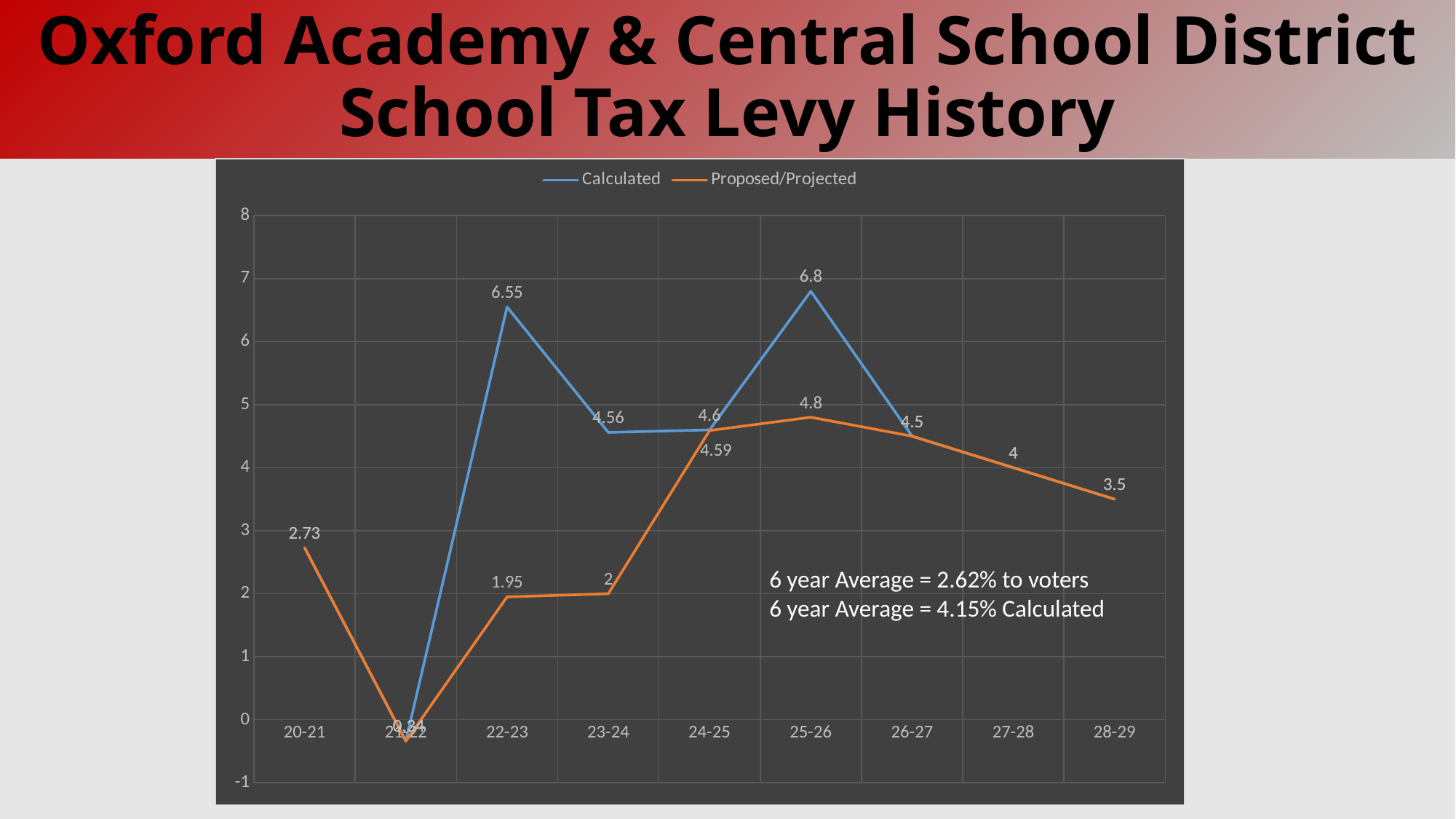
What is the difference between the Calculated values for 25-26 and 22-23? 0.25 For 23-24, which is larger: the Calculated value or the Proposed/Projected value? Calculated What is the Proposed/Projected value for 22-23? 1.95 What is the Proposed/Projected value for 28-29? 3.5 What kind of chart is shown on the slide? Line chart In which year is the Proposed/Projected series highest? 25-26 Does the Proposed/Projected series rise or fall from 25-26 to 28-29? Fall In which year is the Calculated series highest? 25-26 What is the Proposed/Projected value for 20-21? 2.73 What is the Calculated value for 22-23? 6.55 How many school years are shown on the x axis? 9 How many series does the legend list? 2